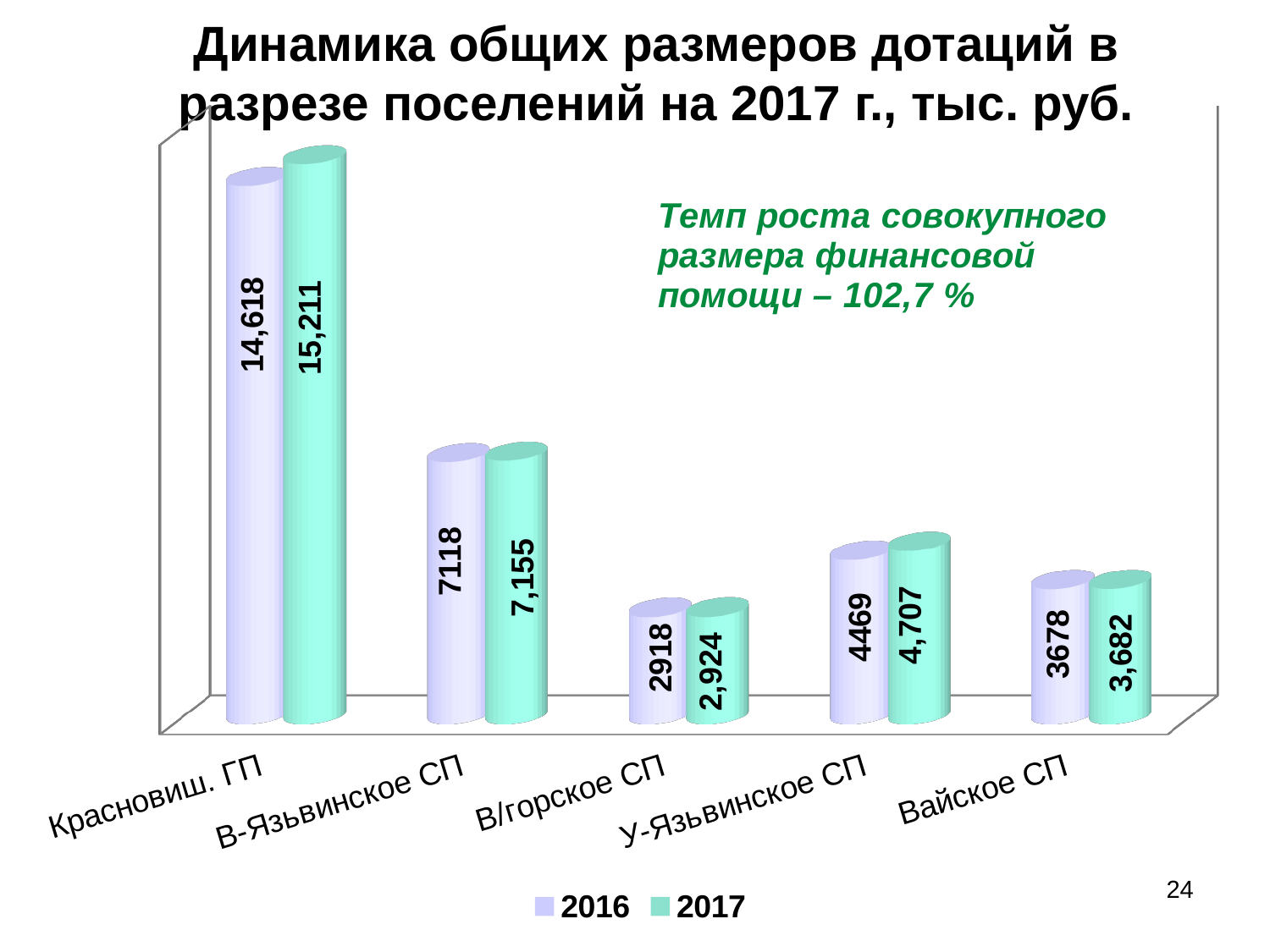
What is the 2017 value for Вайское СП? 3,682 What is the 2016 value for Красновиш. ГП? 14,618 How many series does the legend list? 2 What is the 2016 value for В/горское СП? 2918 Which is larger: the 2016 value for В-Язьвинское СП or the 2016 value for У-Язьвинское СП? В-Язьвинское СП What is the 2017 value for У-Язьвинское СП? 4,707 What is the difference between the 2017 and 2016 values for У-Язьвинское СП? 238 How many settlements are shown on the x axis? 5 Which settlement has the lowest 2016 value? В/горское СП What kind of chart is shown on the slide? Bar chart Which settlement has the highest 2017 value? Красновиш. ГП What is the difference between the 2017 and 2016 values for Красновиш. ГП? 593